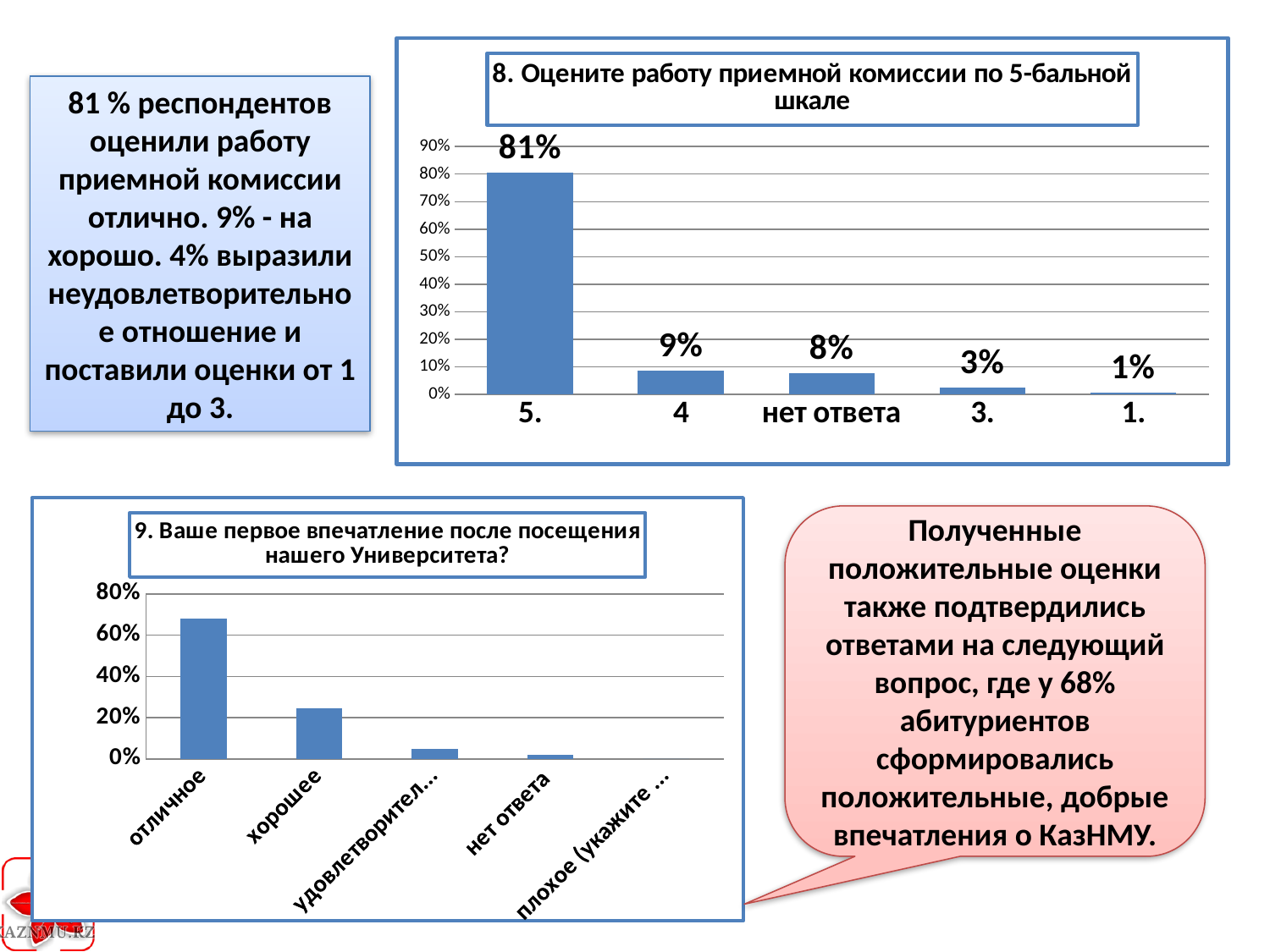
In the top chart '8. Оцените работу приемной комиссии по 5-бальной шкале', what is the value for the category '4'? 9% What type of chart is the bottom chart '9. Ваше первое впечатление после посещения нашего Университета?'? bar chart In the top chart '8. Оцените работу приемной комиссии по 5-бальной шкале', what is the difference between the values for '3.' and '1.'? 2% In the top chart '8. Оцените работу приемной комиссии по 5-бальной шкале', which category has the highest value? 5. In the bottom chart '9. Ваше первое впечатление после посещения нашего Университета?', is the value for 'отличное' greater or less than 60%? greater In the bottom chart '9. Ваше первое впечатление после посещения нашего Университета?', which category has the highest value? отличное In the top chart '8. Оцените работу приемной комиссии по 5-бальной шкале', what percentage of respondents gave a rating of 5? 81% In the top chart '8. Оцените работу приемной комиссии по 5-бальной шкале', which category has the lowest value? 1. In the top chart '8. Оцените работу приемной комиссии по 5-бальной шкале', what is the value for 'нет ответа'? 8% In the top chart '8. Оцените работу приемной комиссии по 5-бальной шкале', what is the difference between the values for '5.' and '4'? 72% In the bottom chart '9. Ваше первое впечатление после посещения нашего Университета?', is the value for 'хорошее' greater or less than 40%? less In the top chart '8. Оцените работу приемной комиссии по 5-бальной шкале', how many categories are shown on the x axis? 5